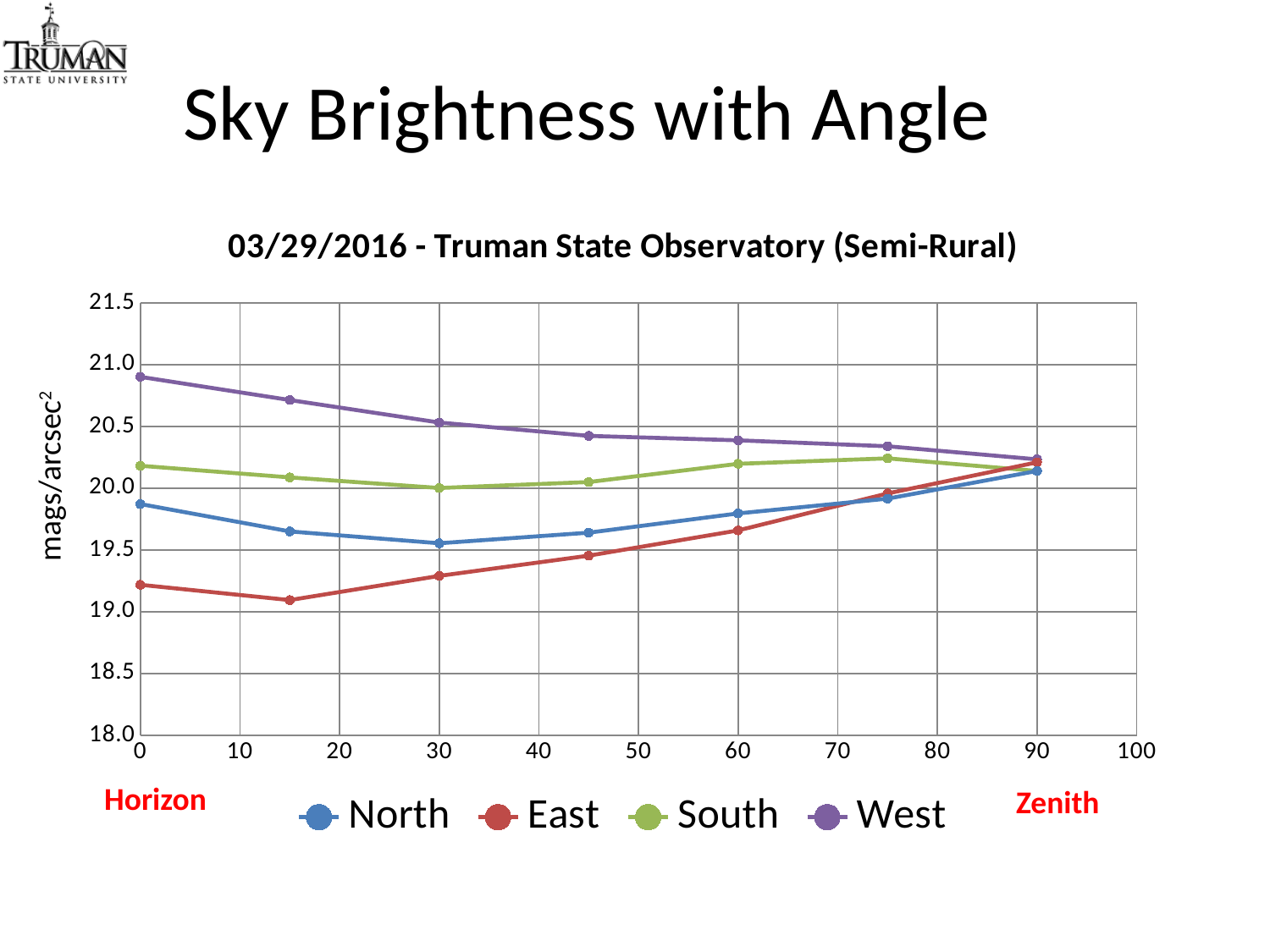
How many data points are plotted for the West series? 7 What kind of chart is shown on the slide? line chart Is the value for North at angle 0 greater or less than 19.5? greater What is the label on the vertical axis? mags/arcsec² Is the value for South at angle 60 greater or less than 20.0? greater Which series has the highest value at angle 0? West Does the West series rise or fall as the angle increases from 0 to 90? fall How many series does the legend list? 4 Is the value for West at angle 0 greater or less than 20.5? greater Which series has the lowest value at angle 0? East Does the East series rise or fall as the angle increases from 15 to 90? rise